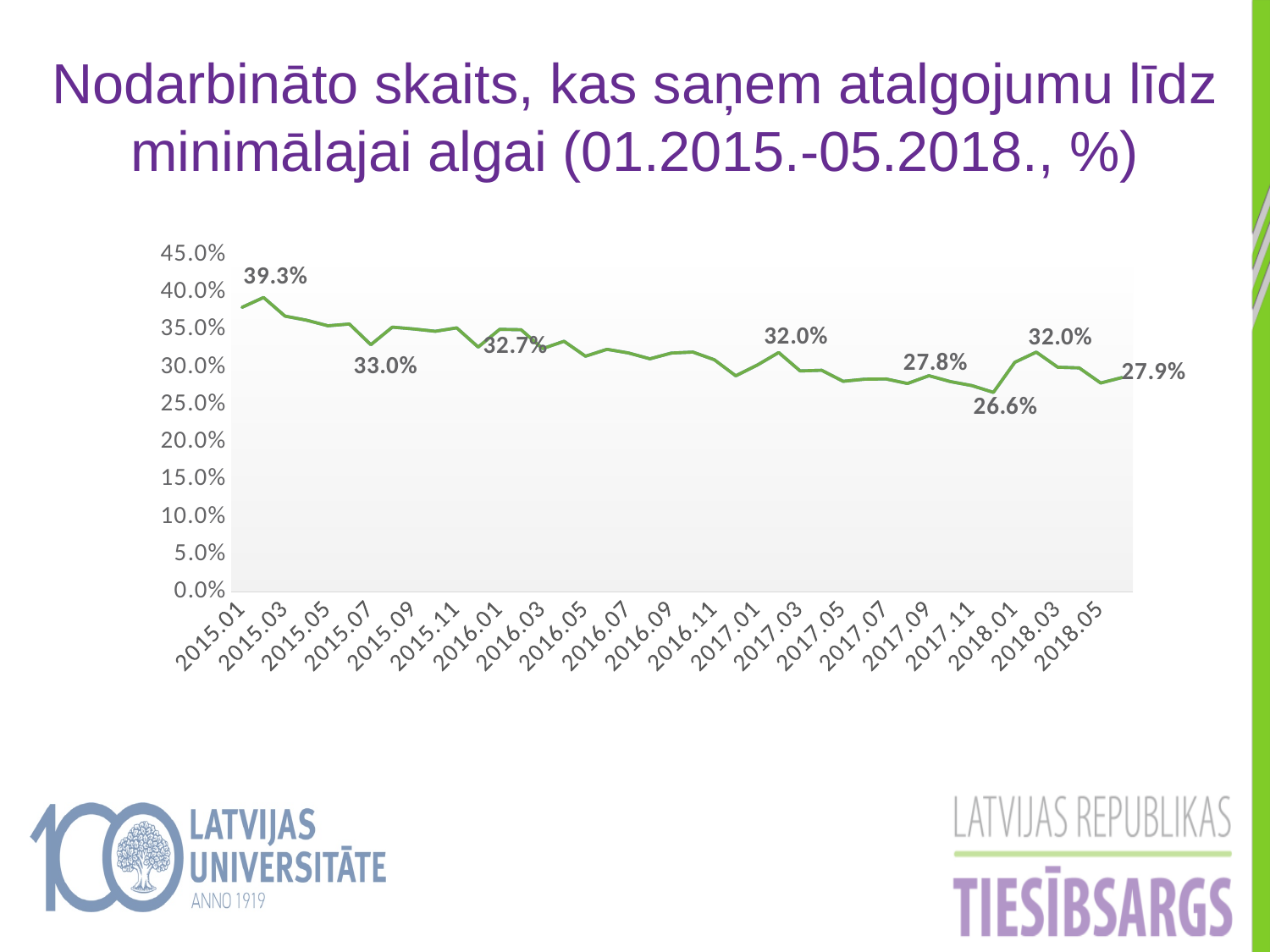
What is the highest value labelled on the chart? 39.3% What is the value shown for the last point, 2018.05? 27.9% How many tick labels are shown on the x axis? 21 What is the highest value shown on the y axis? 45.0% Overall, do the values rise or fall from 2015.01 to 2018.05? fall What is the difference between the highest labelled value (39.3%) and the lowest labelled value (26.6%)? 12.7 percentage points What period does the chart title say the data covers? 01.2015.-05.2018. What is the lowest value labelled on the chart? 26.6% What kind of chart is shown on the slide? line chart Is the value for 2017.05 greater or less than 30%? less Is the value for 2015.01 greater or less than 35%? greater Which is larger, the labelled value 39.3% at the start of 2015 or the value 27.9% at 2018.05? 39.3% at the start of 2015